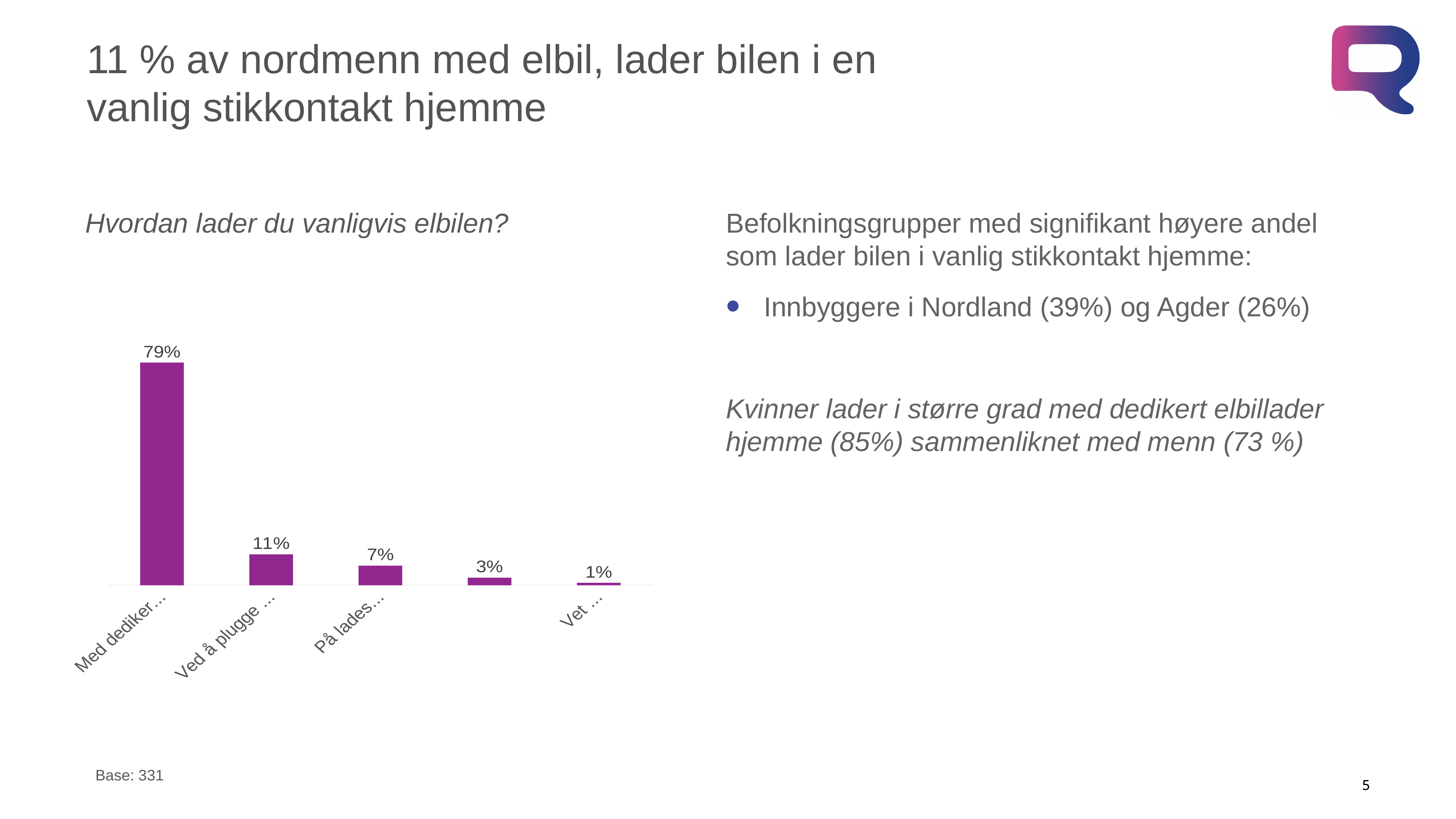
What kind of chart is shown on the slide? Bar chart Which category has the highest value in the chart? Med dediker… (the first bar), 79% What is the value of the second bar (Ved å plugge …)? 11% What is the value of the fourth bar in the chart? 3% Do the bar values rise or fall from left to right across the chart? Fall What is the value of the first bar (Med dediker…)? 79% Which is larger, the second bar (Ved å plugge …) or the third bar (På lades…)? The second bar (Ved å plugge …), 11% What is the value of the third bar (På lades…)? 7% How many bars (categories) does the chart show? 5 Which category has the lowest value in the chart? Vet … (the last bar), 1% What question is shown as the title above the chart? Hvordan lader du vanligvis elbilen? What is the difference between the first bar (79%) and the second bar (11%)? 68 percentage points